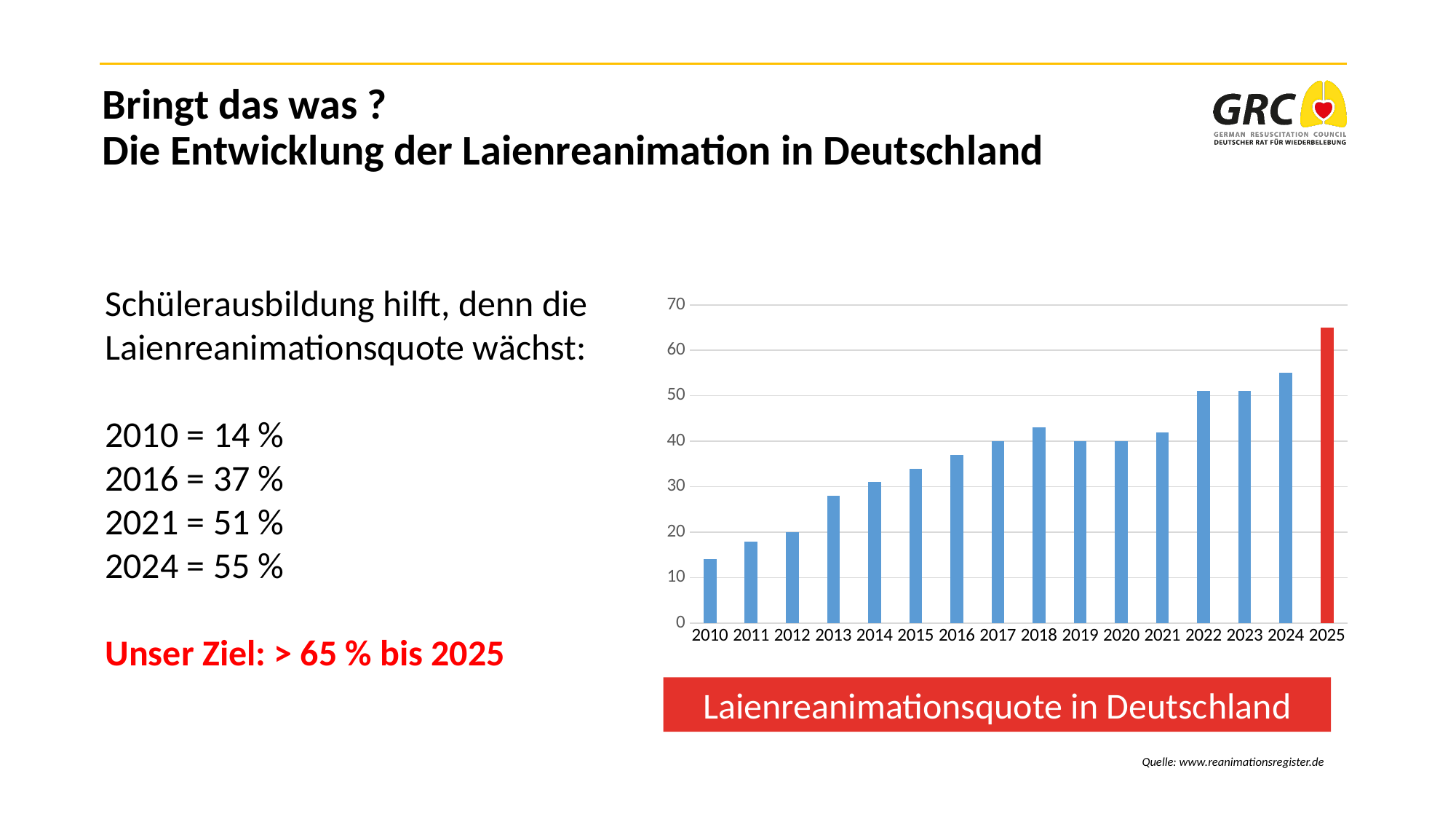
What is the Laienreanimationsquote for 2024 according to the slide? 55 % Which year has the highest bar in the chart? 2025 What type of chart is shown on the slide? bar chart What is the title shown below the chart? Laienreanimationsquote in Deutschland How many years are shown on the x axis of the chart? 16 What is the Laienreanimationsquote for 2010 according to the slide? 14 % Which year has the larger bar, 2018 or 2019? 2018 Is the value for 2013 greater or less than 30? less Is the value for 2025 greater or less than 60? greater By how many percentage points did the Laienreanimationsquote rise from 2010 to 2024? 41 Which year has the lowest bar in the chart? 2010 What is the Laienreanimationsquote for 2016 according to the slide? 37 %